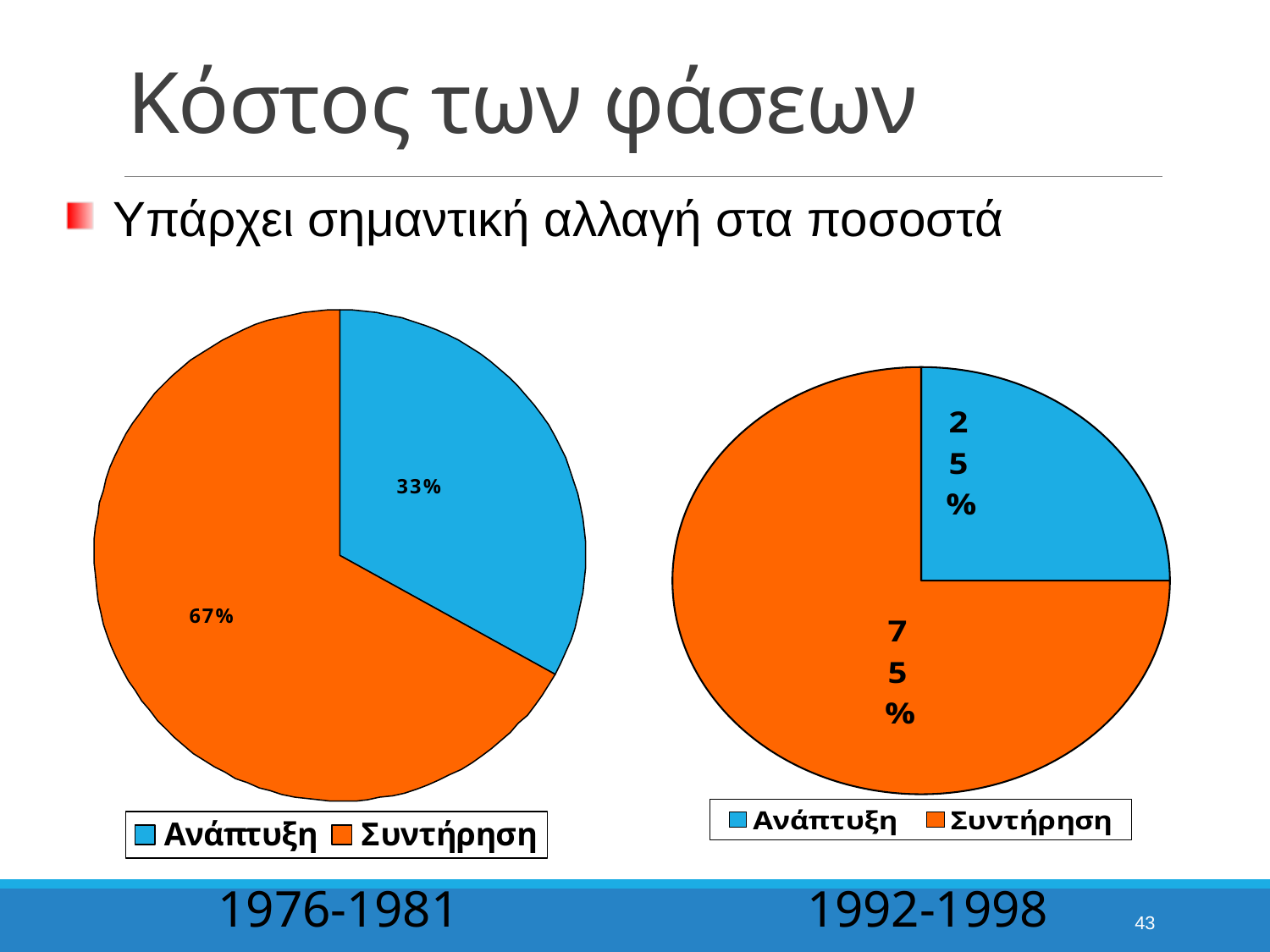
How many slices does the left pie chart (1976-1981) have? 2 In the left pie chart (1976-1981), what share does Ανάπτυξη have? 33% In the right pie chart (1992-1998), what is the difference between the Συντήρηση and Ανάπτυξη shares? 50% Is the Ανάπτυξη share larger in the left pie chart (1976-1981) or the right pie chart (1992-1998)? Left (1976-1981) In the left pie chart (1976-1981), which category has the largest slice? Συντήρηση In the right pie chart (1992-1998), which colour represents Συντήρηση? Orange In the right pie chart (1992-1998), what share does Ανάπτυξη have? 25% What type of chart is used on this slide? Pie chart In the left pie chart (1976-1981), what share does Συντήρηση have? 67% In the right pie chart (1992-1998), which category has the smallest slice? Ανάπτυξη In the left pie chart (1976-1981), what is the difference between the Συντήρηση and Ανάπτυξη shares? 34% In the right pie chart (1992-1998), what share does Συντήρηση have? 75%